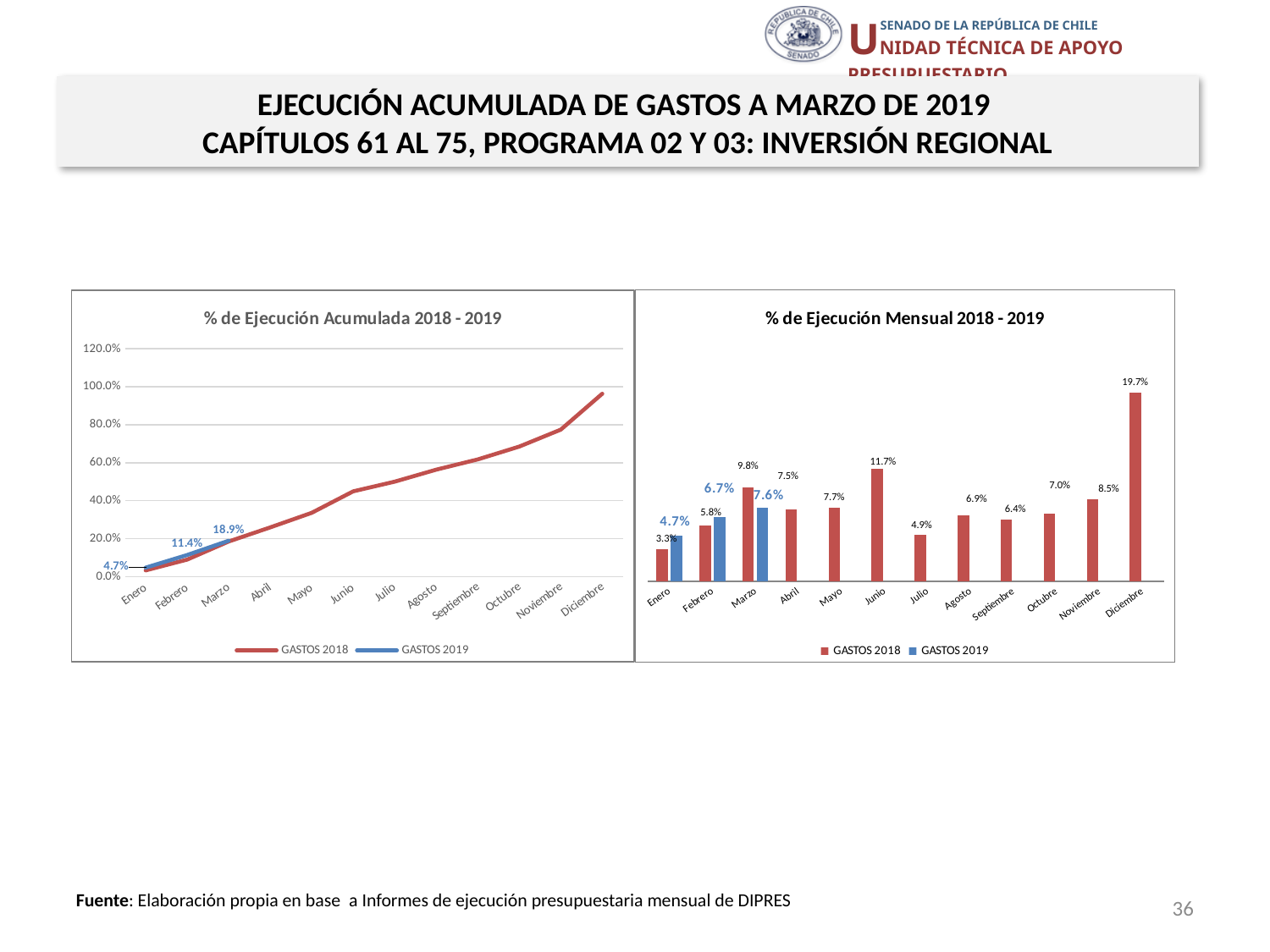
In the chart titled '% de Ejecución Acumulada 2018 - 2019', what is the GASTOS 2019 value for Marzo? 18.9% In the chart titled '% de Ejecución Mensual 2018 - 2019', how many months are shown on the x axis? 12 In the chart titled '% de Ejecución Mensual 2018 - 2019', which is larger for Enero: GASTOS 2018 or GASTOS 2019? GASTOS 2019 In the chart titled '% de Ejecución Mensual 2018 - 2019', which month has the highest GASTOS 2018 value? Diciembre In the chart titled '% de Ejecución Mensual 2018 - 2019', what is the difference between the GASTOS 2018 and GASTOS 2019 values for Marzo? 2.2% What kind of chart is the one titled '% de Ejecución Mensual 2018 - 2019'? Bar chart In the chart titled '% de Ejecución Mensual 2018 - 2019', what is the GASTOS 2018 value for Diciembre? 19.7% In the chart titled '% de Ejecución Mensual 2018 - 2019', which month has the lowest GASTOS 2018 value? Enero In the chart titled '% de Ejecución Mensual 2018 - 2019', what is the GASTOS 2019 value for Marzo? 7.6% In the chart titled '% de Ejecución Acumulada 2018 - 2019', how many series does the legend list? 2 What kind of chart is the one titled '% de Ejecución Acumulada 2018 - 2019'? Line chart In the chart titled '% de Ejecución Acumulada 2018 - 2019', is the GASTOS 2018 value for Diciembre greater or less than 80.0%? greater